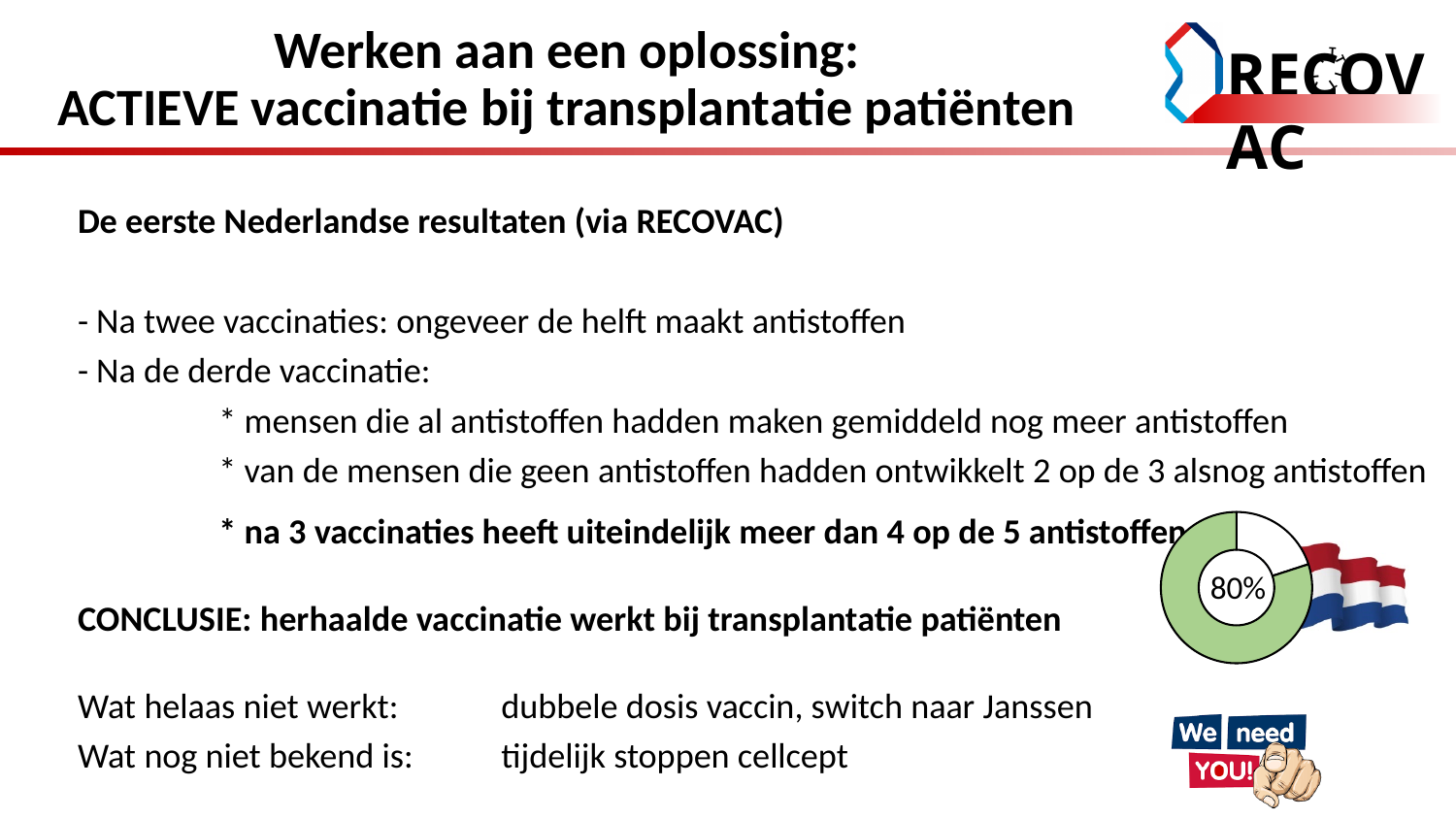
Which segment of the donut chart is larger, the green one or the white one? the green one What share of the donut chart does the green segment represent? 80% Does the donut chart have a legend? No What share of the donut chart does the white segment represent? 20% What value is printed in the centre of the donut chart? 80% What colour is the larger segment of the donut chart? green How many segments does the donut chart have? 2 What kind of chart is shown on the slide next to the Dutch flag? pie chart (donut)